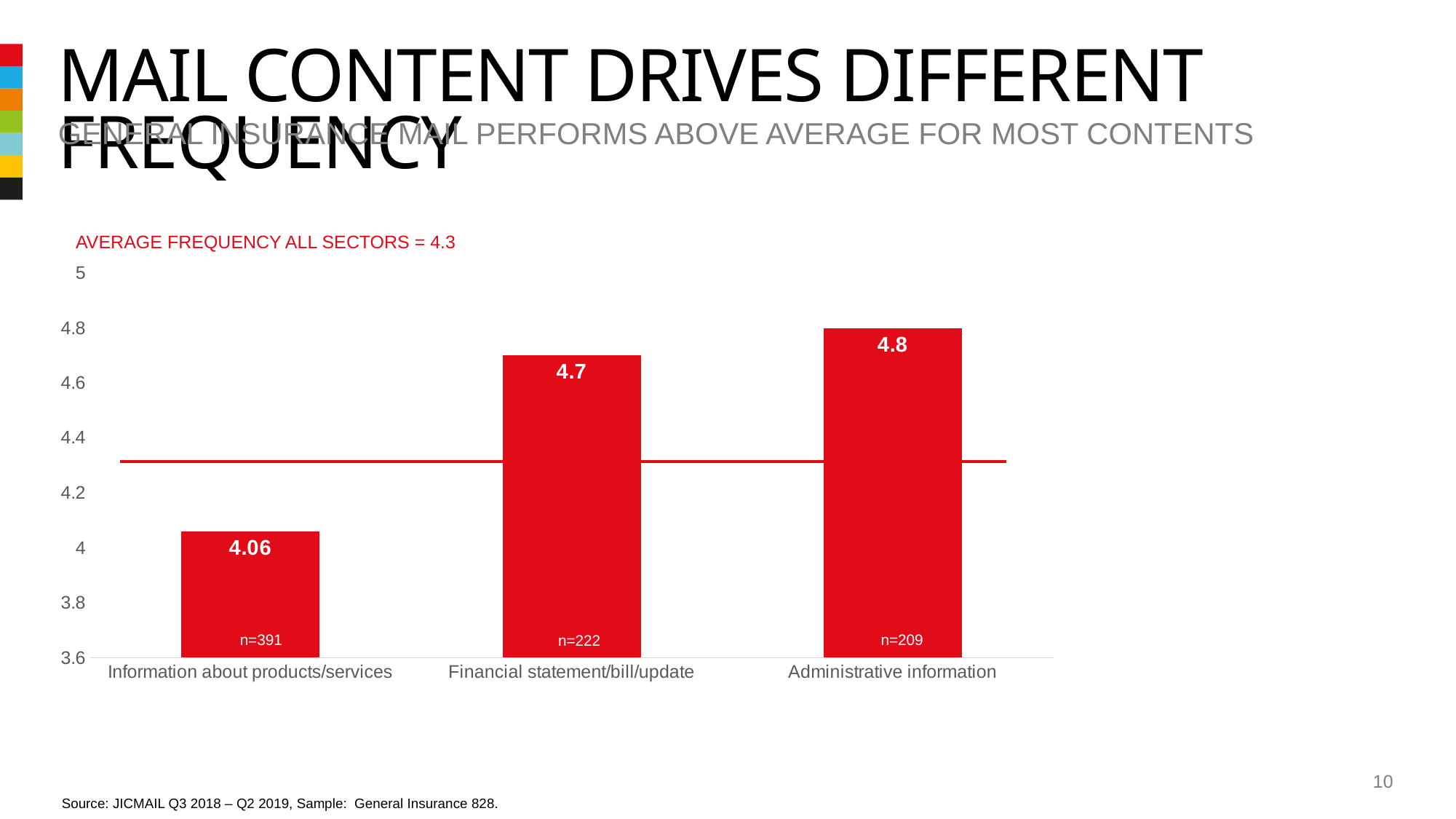
Which category has the highest value? Administrative information What is the difference between the values for Administrative information and Information about products/services? 0.74 What is the value for Information about products/services? 4.06 What is the value for Administrative information? 4.8 What kind of chart is shown on the slide? bar chart Which category has the lowest value? Information about products/services Which is larger, the value for Financial statement/bill/update or the value for Information about products/services? Financial statement/bill/update What is the value for Financial statement/bill/update? 4.7 How many categories are shown on the chart? 3 Do the values rise or fall from left to right across the categories? rise What is the average frequency for all sectors stated above the chart? 4.3 Is the value for Information about products/services greater or less than 4.2? less